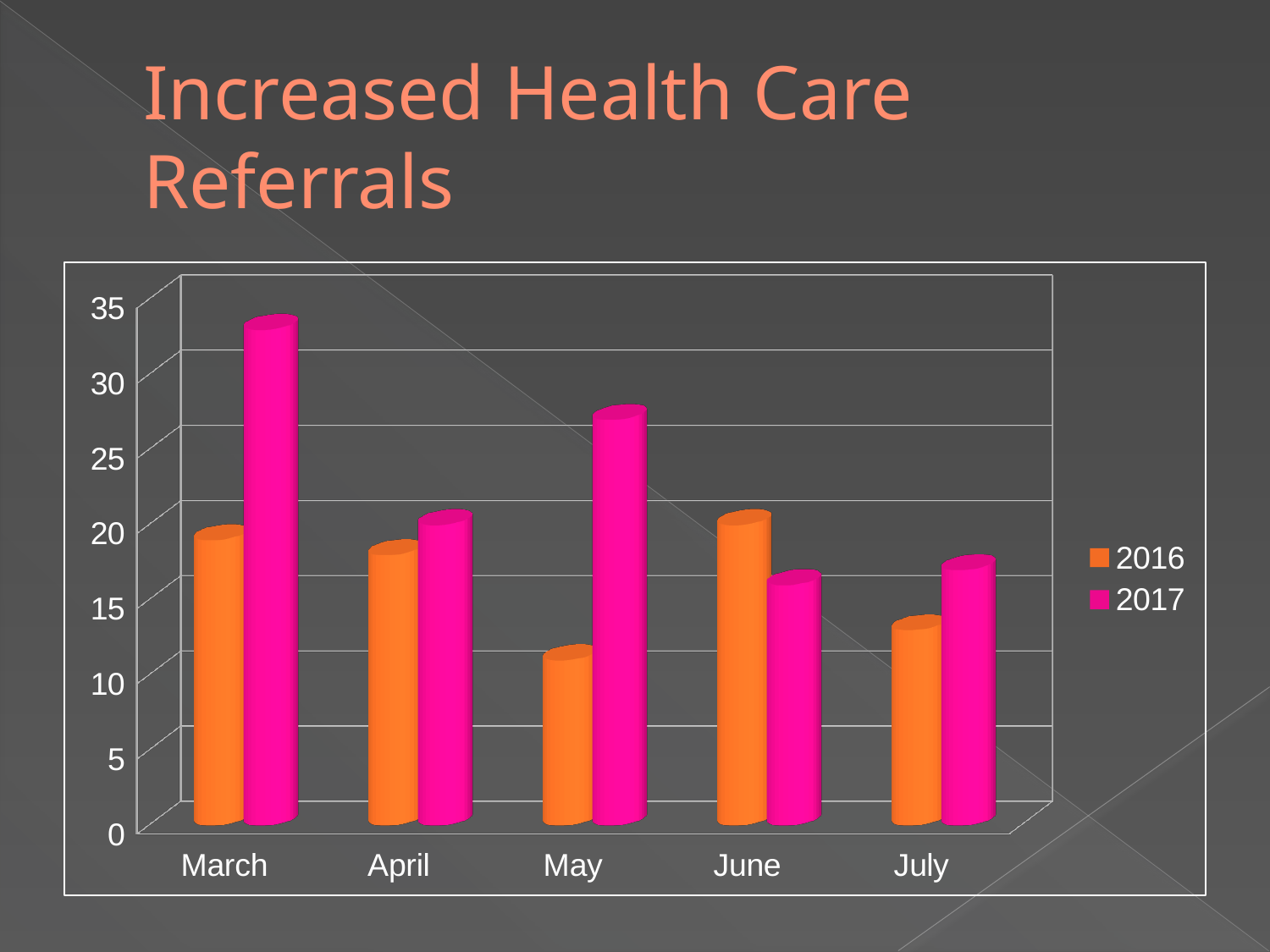
What kind of chart is shown on the slide? bar chart Which month has the lowest value for 2016? May Is the value for 2017 in March greater or less than 30? greater Which colour represents the 2017 series in the legend? pink Is the value for 2016 in May greater or less than 15? less How many series does the legend list? 2 In March, which series has the larger value, 2016 or 2017? 2017 How many months are shown on the x axis? 5 Is the value for 2017 in May greater or less than 25? greater What is the title of the slide? Increased Health Care Referrals Which month has the highest value for 2017? March In June, which series has the larger value, 2016 or 2017? 2016